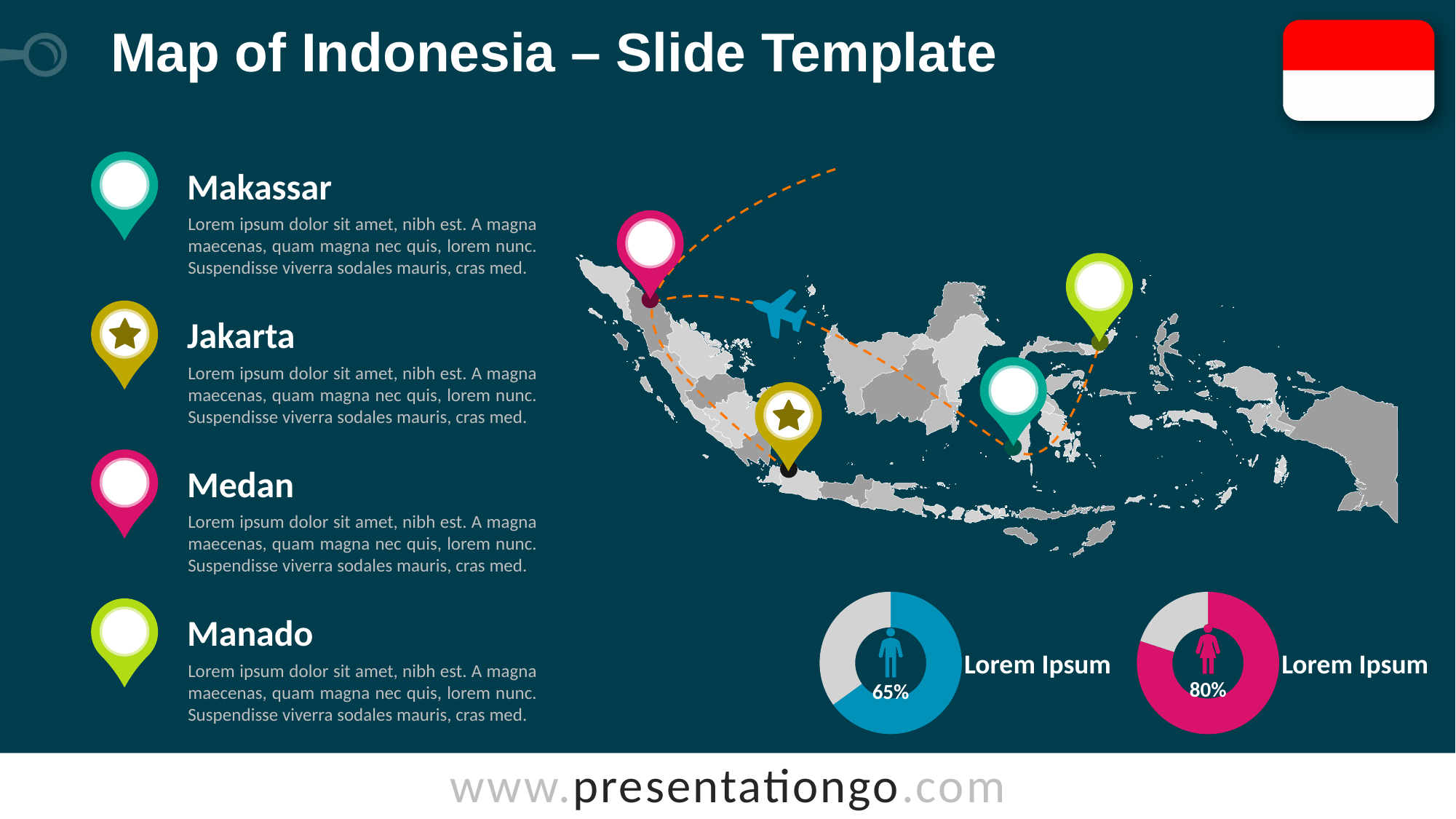
What percentage is shown on the left donut chart (the blue one with the male icon)? 65% What kind of charts are shown at the bottom right of the slide? donut charts Is the value shown on the left donut chart greater or less than 50%? greater What percentage is shown on the right donut chart (the pink one with the female icon)? 80% What is the difference between the percentages shown on the right donut chart and the left donut chart? 15% Is the value shown on the right donut chart greater or less than 75%? greater How many donut charts are shown on the slide? 2 Which donut chart shows the higher percentage, the blue one on the left or the pink one on the right? the pink one on the right What colour is the filled portion of the right donut chart? pink What label appears next to the left donut chart? Lorem Ipsum